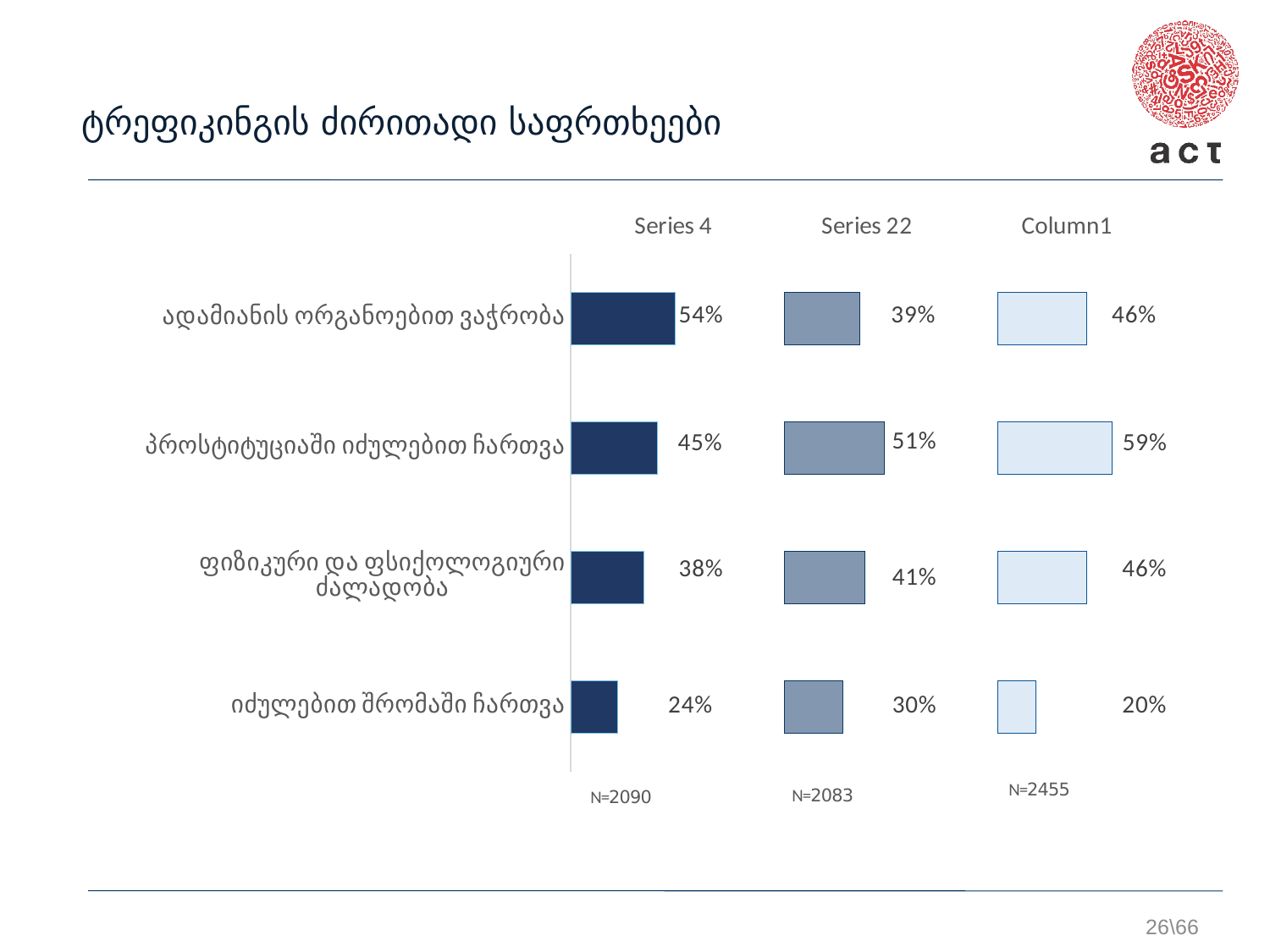
What is the title of the slide? ტრეფიკინგის ძირითადი საფრთხეები What is the value for "ადამიანის ორგანოებით ვაჭრობა" in Series 4? 54% What is the difference between the Series 4 and Series 22 values for "ადამიანის ორგანოებით ვაჭრობა"? 15% Which category has the lowest value in Column1? იძულებით შრომაში ჩართვა How many series does the chart show? 3 What is the value for "იძულებით შრომაში ჩართვა" in Series 22? 30% Which category has the highest value in Series 4? ადამიანის ორგანოებით ვაჭრობა What kind of chart is shown on the slide? bar chart How many categories are shown in the chart? 4 What is the value for "პროსტიტუციაში იძულებით ჩართვა" in Column1? 59% What is the sample size (N) shown under the Column1 series? N=2455 Which is larger for "ფიზიკური და ფსიქოლოგიური ძალადობა": the Series 22 value or the Column1 value? Column1